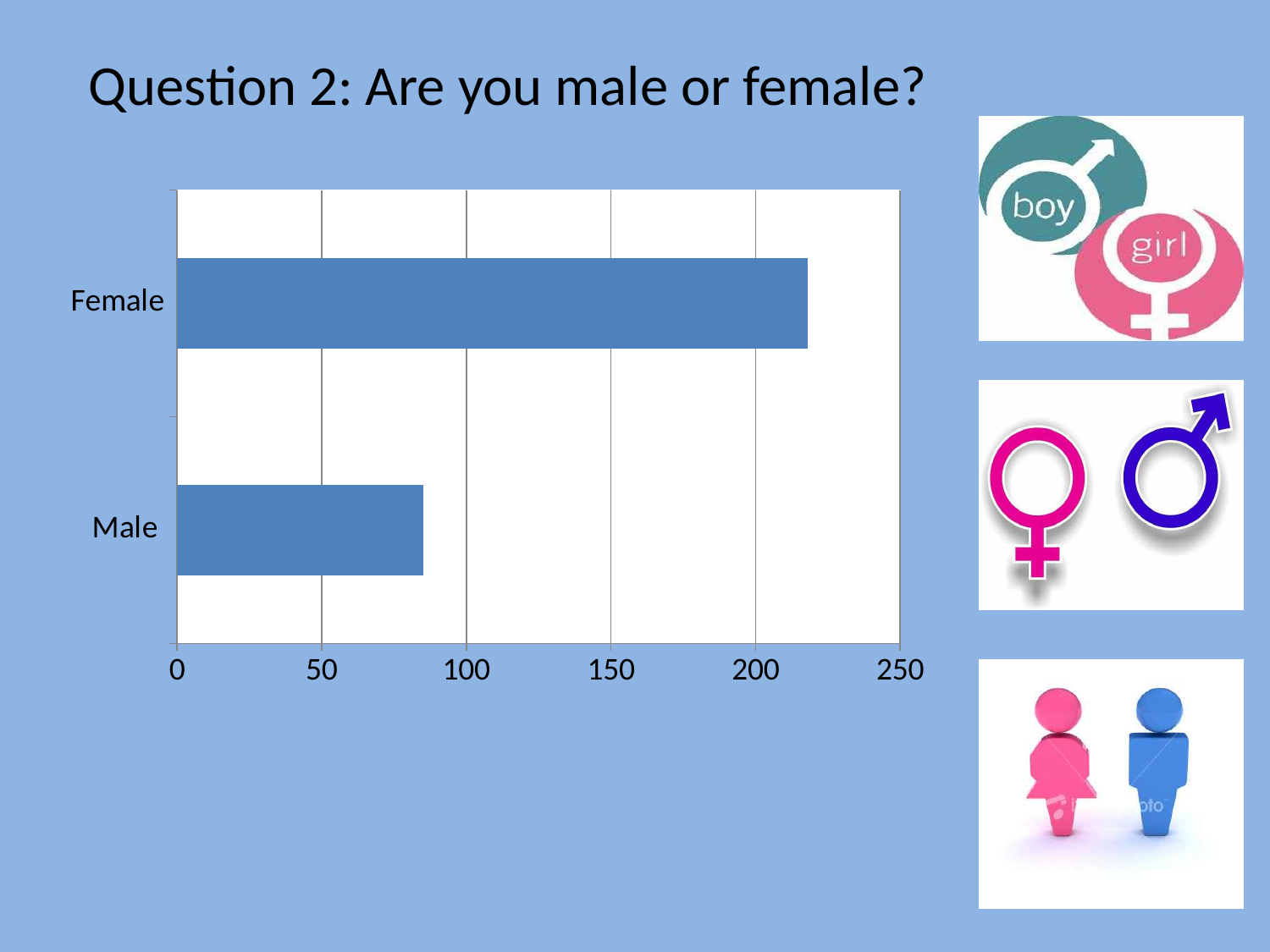
Which category has the highest value in the chart? Female What kind of chart is shown on the slide? bar chart Is the value for Female greater or less than 250? less Which category has the lowest value in the chart? Male What is the highest value shown on the horizontal axis of the chart? 250 How many categories are plotted in the chart? 2 Is the value for Female greater or less than 200? greater Which is larger, the value for Female or the value for Male? Female Is the value for Male greater or less than 100? less What is the title of the slide containing the chart? Question 2: Are you male or female?